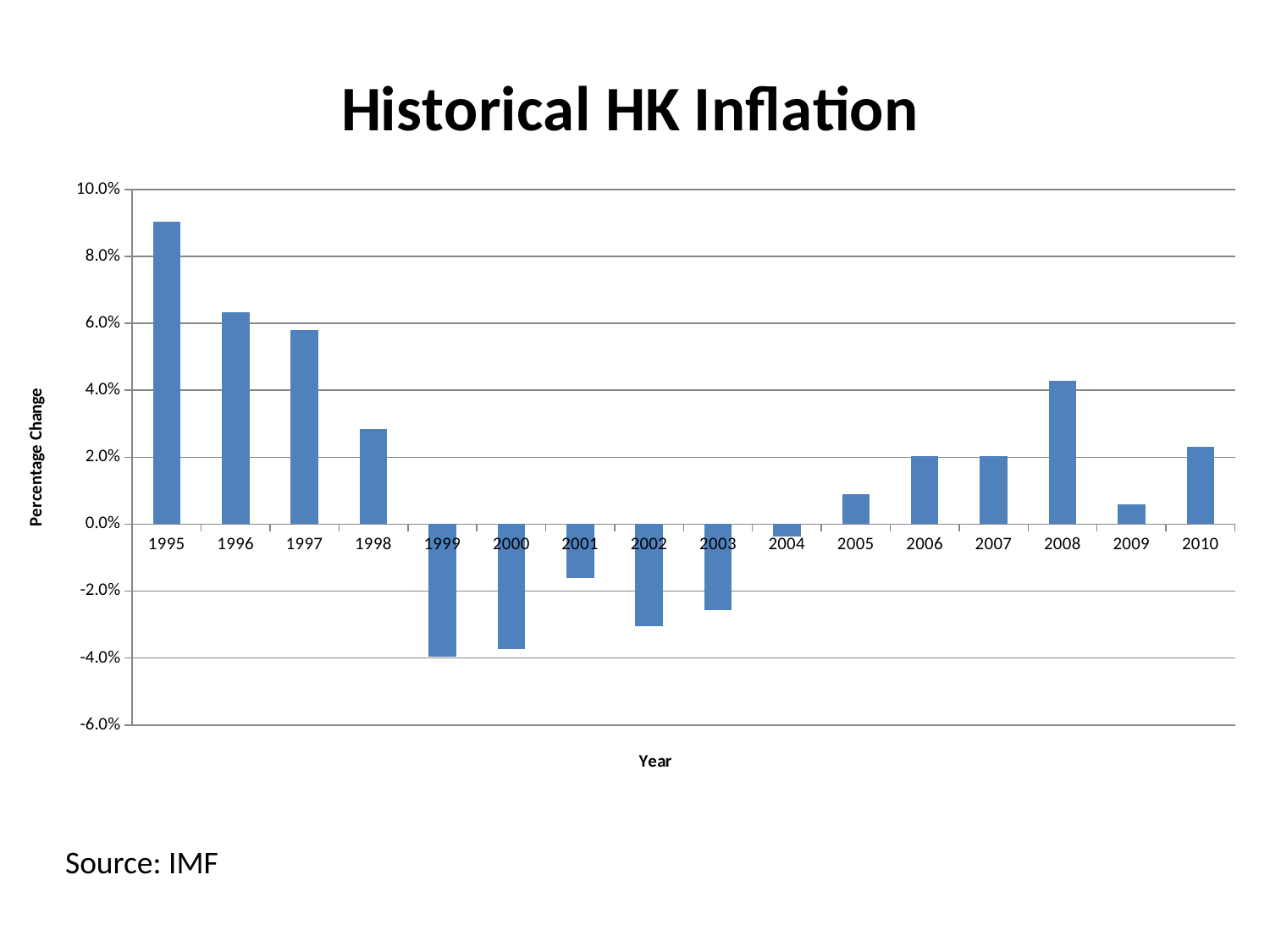
What is the label on the vertical axis of the chart? Percentage Change What kind of chart is shown on the slide? bar chart Which year has the larger value, 1996 or 1997? 1996 Is the value for 1995 greater or less than 8.0%? greater How many years are plotted on the chart? 16 Is the value for 1998 greater or less than 2.0%? greater Is the value for 2002 greater or less than -2.0%? less What is the title of the chart? Historical HK Inflation Which year has the lowest inflation value on the chart? 1999 Do the values rise or fall from 1995 to 1999? fall Which year has the highest inflation value on the chart? 1995